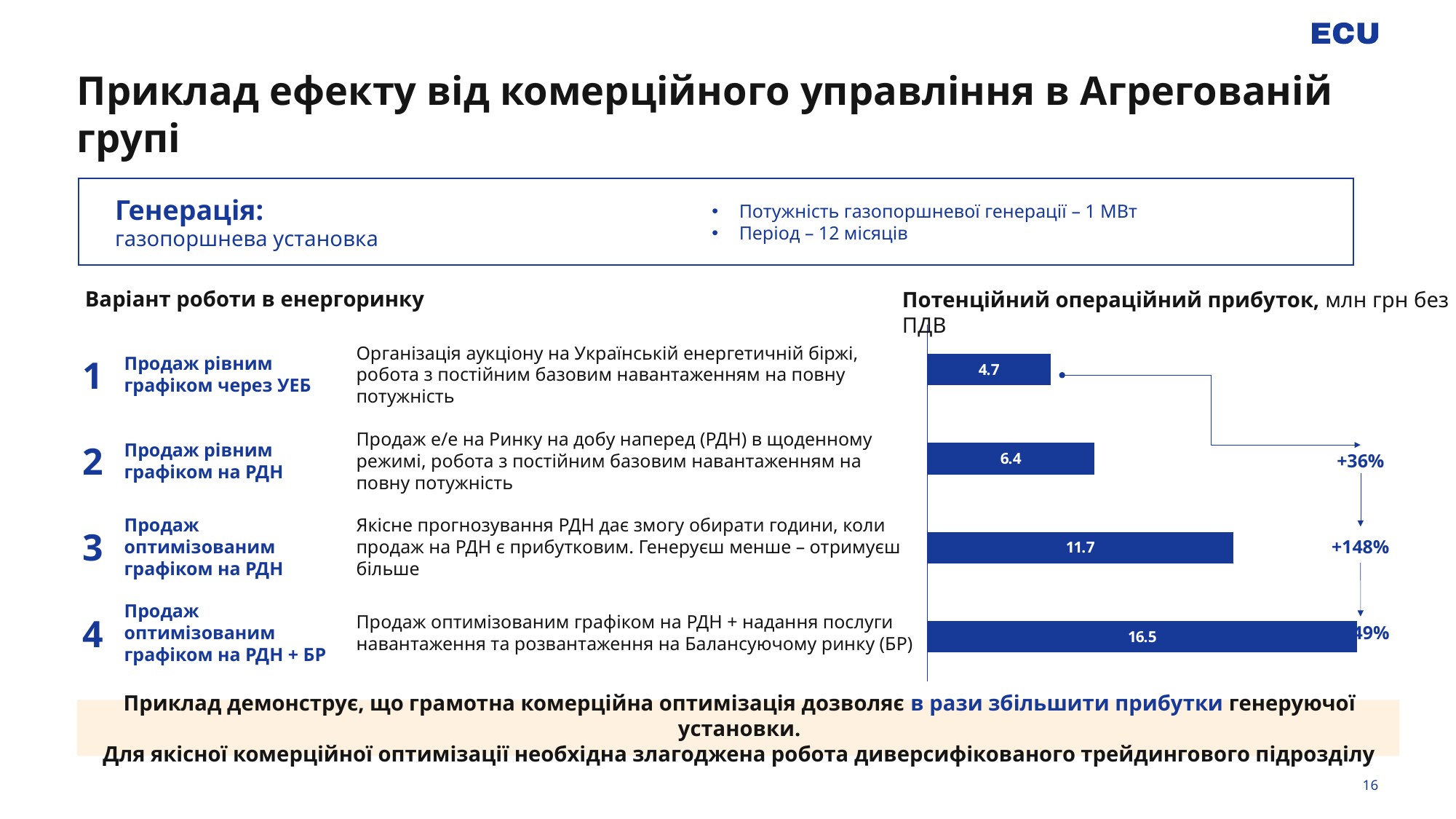
What is the potential operating profit (млн грн без ПДВ) for option 3, 'Продаж оптимізованим графіком на РДН'? 11.7 How many bars are shown in the potential operating profit chart? 4 Which option has the lowest potential operating profit in the chart? Option 1 (Продаж рівним графіком через УЕБ) What is the difference in potential operating profit between option 3 and option 2? 5.3 Which option has the highest potential operating profit in the chart? Option 4 (Продаж оптимізованим графіком на РДН + БР) What is the potential operating profit (млн грн без ПДВ) for option 4, 'Продаж оптимізованим графіком на РДН + БР'? 16.5 What is the difference in potential operating profit between option 4 (16.5) and option 1 (4.7)? 11.8 What is the potential operating profit (млн грн без ПДВ) for option 2, 'Продаж рівним графіком на РДН'? 6.4 What is the potential operating profit (млн грн без ПДВ) for option 1, 'Продаж рівним графіком через УЕБ'? 4.7 What percentage increase is annotated between option 1 and option 2 in the chart? +36% What type of chart is used to show the potential operating profit? Bar chart Which has a larger potential operating profit: option 2 or option 3? Option 3